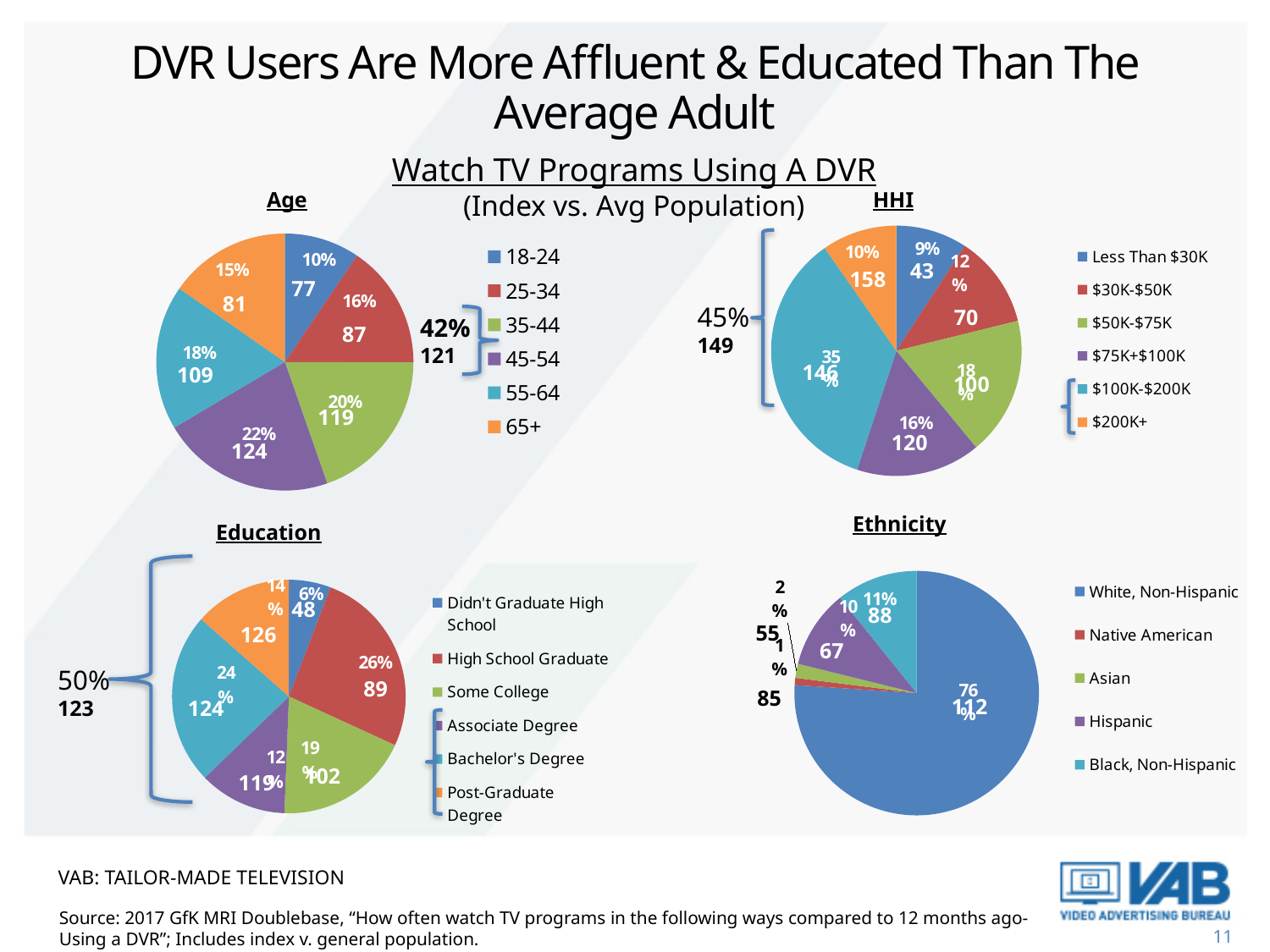
How many categories does the legend of the Ethnicity chart list? 5 In the Age chart, which age group has the largest slice? 45-54 In the HHI chart, what percentage share is shown for the $75K+$100K slice? 16% In the Education chart, what percentage share is shown for the High School Graduate slice? 26% In the Ethnicity chart, what percentage share is shown for the White, Non-Hispanic slice? 76% In the Age chart, what index value is shown for the 18-24 slice? 77 In the Education chart, what is the difference between the index values for Post-Graduate Degree (126) and Didn't Graduate High School (48)? 78 How many entries does the legend of the HHI chart list? 6 In the HHI chart, what index value is shown for the $200K+ slice? 158 In the HHI chart, which income group has the smallest slice? Less Than $30K What type of chart is the Age chart? pie chart In the Age chart, what percentage share is shown for the 45-54 slice? 22%